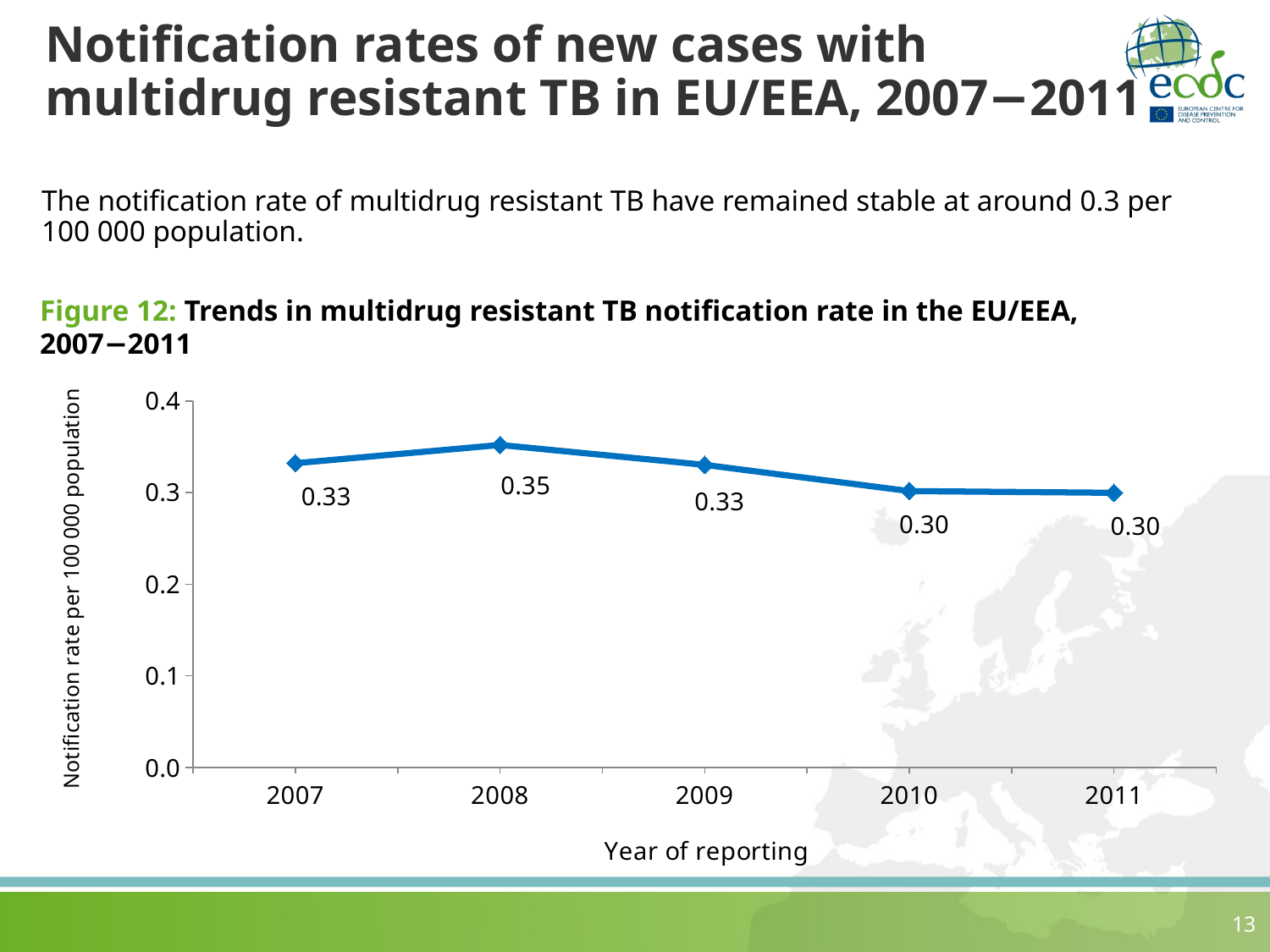
What is the difference between the notification rate in 2008 and in 2010? 0.05 What is the notification rate per 100 000 population in 2008? 0.35 What is the notification rate per 100 000 population in 2011? 0.30 What is the notification rate per 100 000 population in 2007? 0.33 Does the notification rate rise or fall from 2008 to 2011? fall What is the label of the y axis? Notification rate per 100 000 population Is the notification rate in 2008 greater or less than 0.3? greater What kind of chart is shown on the slide? line chart Which year has the highest notification rate? 2008 Which is larger, the notification rate in 2009 or in 2011? 2009 How many years are plotted on the chart? 5 What is the label of the x axis? Year of reporting